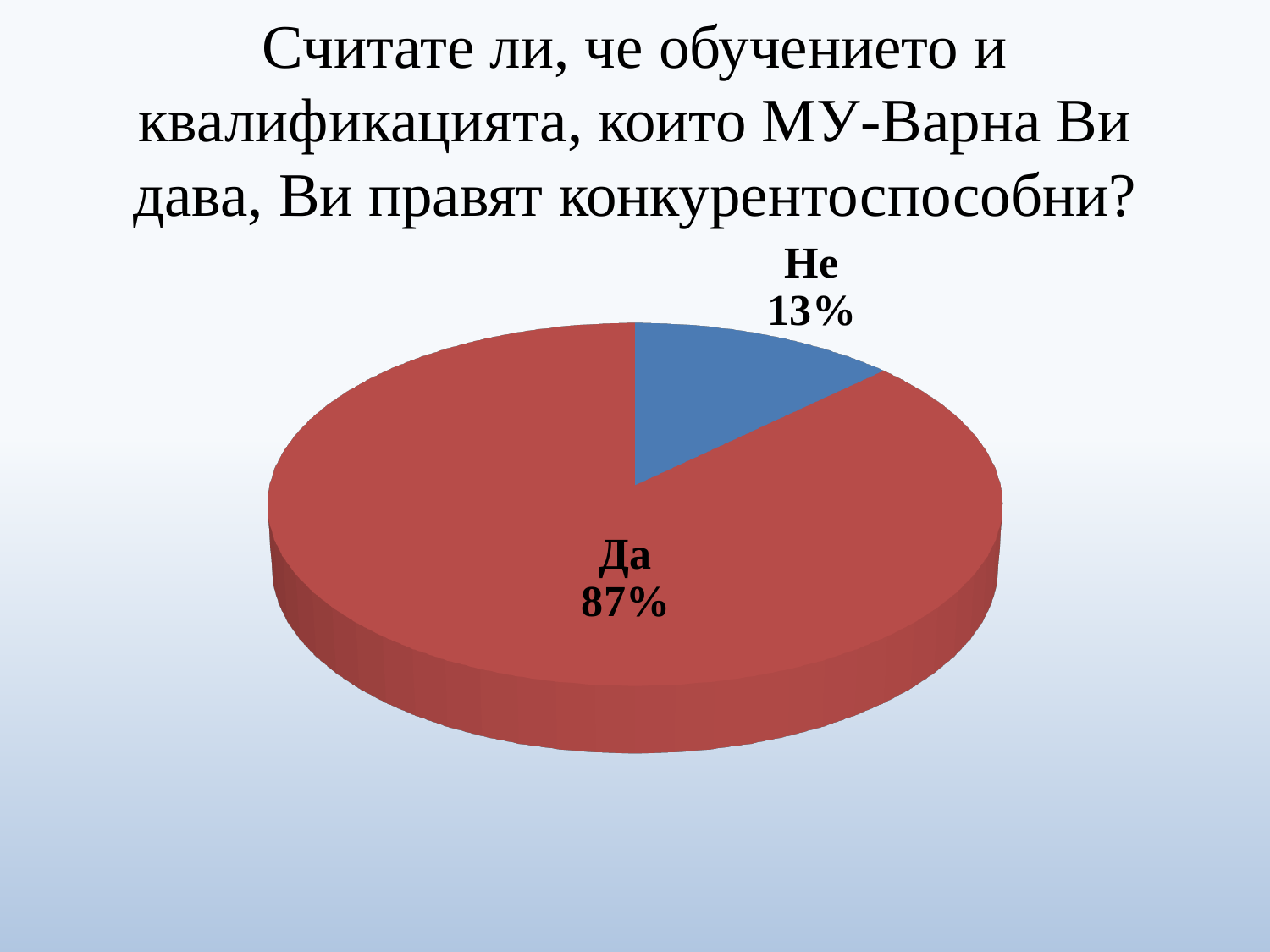
What share of the pie does the "Да" slice represent? 87% What is the difference in percentage points between the "Да" and "Не" slices? 74 Which slice of the pie is the smallest? Не Which is larger, the "Да" slice or the "Не" slice? Да How many slices does the pie chart have? 2 What kind of chart is shown on the slide? pie chart What colour is the "Да" slice? red What share of the pie does the "Не" slice represent? 13% Which slice of the pie is the largest? Да What colour is the "Не" slice? blue